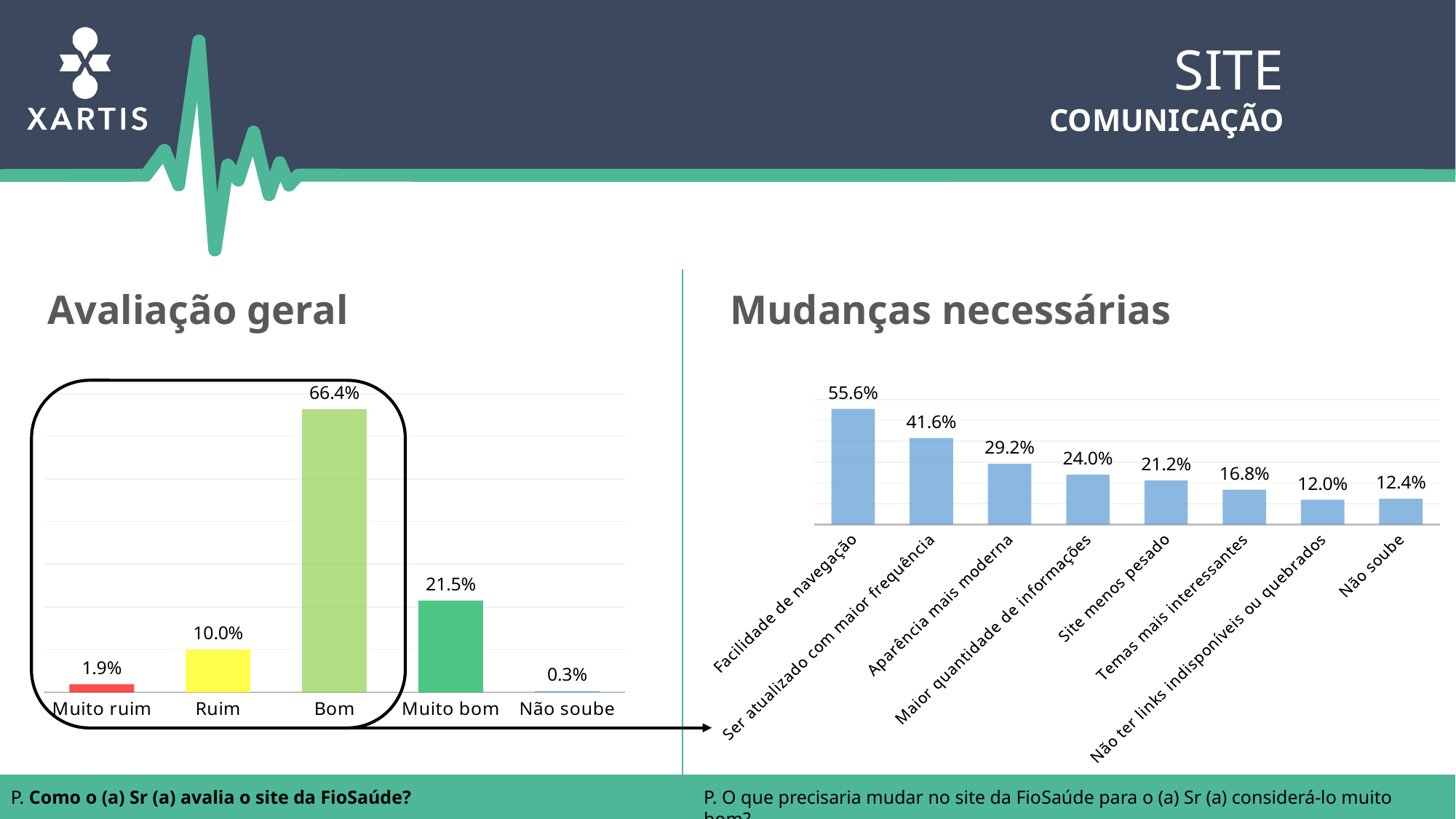
In the 'Mudanças necessárias' chart, which is larger: 'Maior quantidade de informações' or 'Temas mais interessantes'? Maior quantidade de informações In the 'Mudanças necessárias' chart, what is the value for 'Facilidade de navegação'? 55.6% In the 'Avaliação geral' chart, what is the value for 'Muito bom'? 21.5% In the 'Mudanças necessárias' chart, how many categories are shown? 8 What kind of chart is the 'Avaliação geral' chart? Bar chart In the 'Avaliação geral' chart, what is the value for 'Bom'? 66.4% In the 'Mudanças necessárias' chart, which category has the lowest value? Não ter links indisponíveis ou quebrados In the 'Avaliação geral' chart, what is the difference between 'Ruim' and 'Muito ruim'? 8.1% In the 'Avaliação geral' chart, which category has the lowest value? Não soube In the 'Mudanças necessárias' chart, what is the value for 'Site menos pesado'? 21.2% In the 'Avaliação geral' chart, how many categories are shown? 5 In the 'Mudanças necessárias' chart, what is the difference between 'Ser atualizado com maior frequência' and 'Aparência mais moderna'? 12.4%